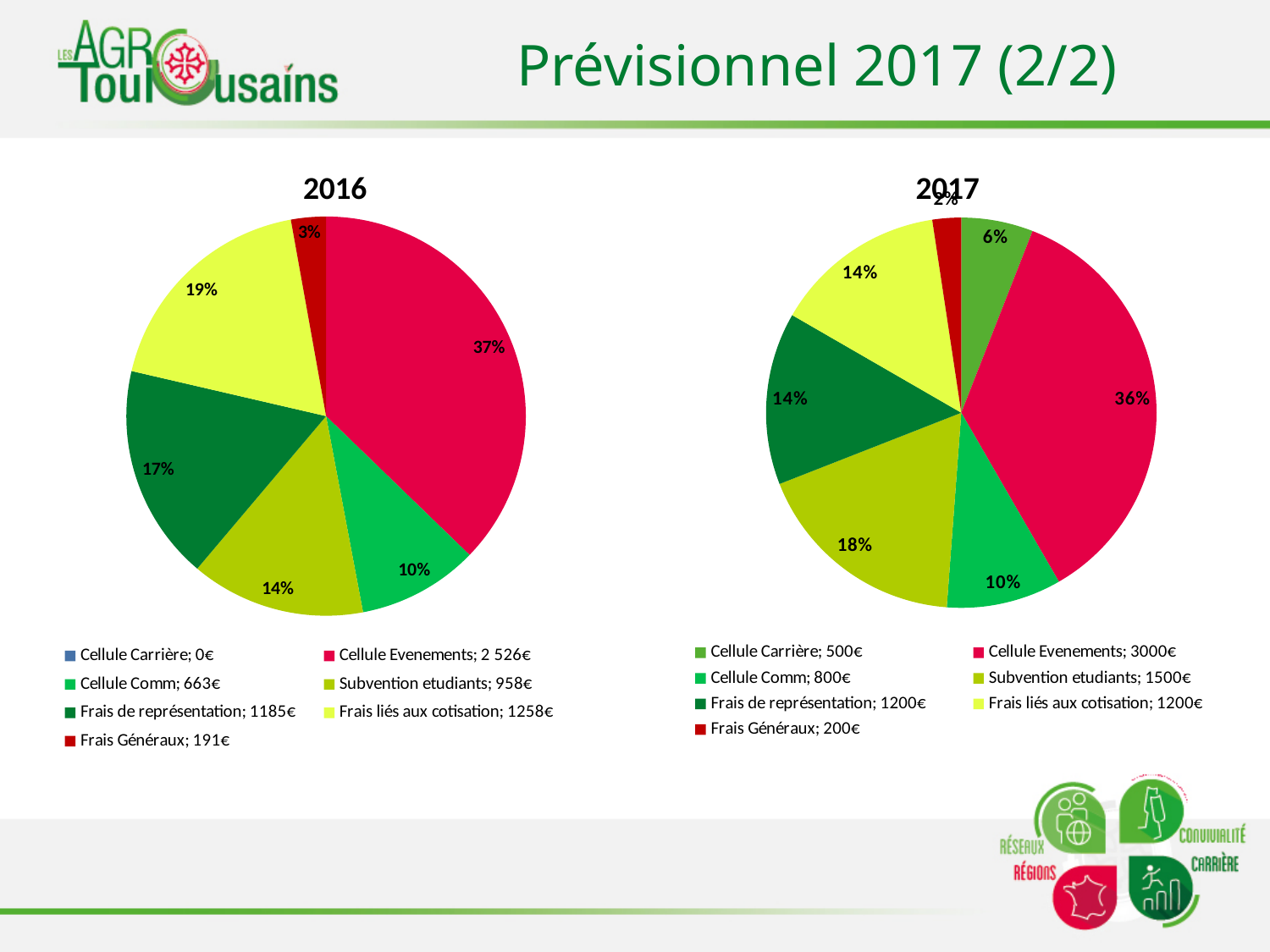
What type of chart is used for the 2016 data? Pie chart In the 2017 pie chart, what share of the pie does Subvention etudiants represent? 18% In the 2016 chart, which category with a visible slice has the smallest share? Frais Généraux In the 2016 chart, what is the value shown in the legend for Frais liés aux cotisation? 1258€ How many categories does the legend of the 2017 chart list? 7 In the 2016 pie chart, what share of the pie does Cellule Evenements represent? 37% In the 2017 chart, what is the value shown in the legend for Cellule Evenements? 3000€ What is the title of the chart on the right side of the slide? 2017 In the 2016 chart, what is the legend value for Cellule Carrière? 0€ In the 2017 chart, which is larger: Frais de représentation or Subvention etudiants? Subvention etudiants In the 2017 chart, which category has the largest slice? Cellule Evenements What is the difference between the Cellule Evenements value in 2017 (3000€) and in 2016 (2 526€)? 474€